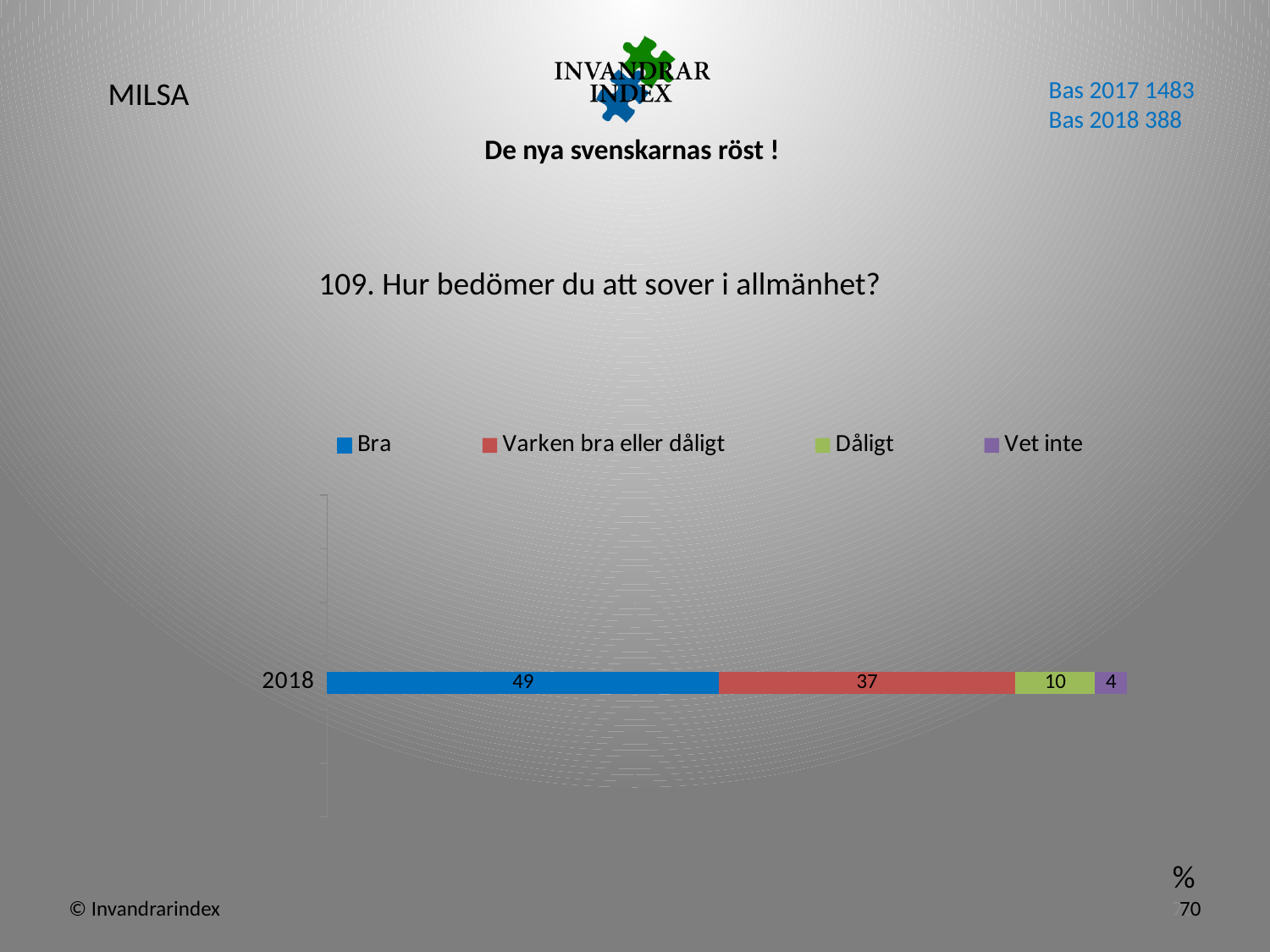
What is the value for "Bra" in the 2018 bar? 49 Which is larger in 2018, "Dåligt" or "Vet inte"? Dåligt What is the value for "Varken bra eller dåligt" in the 2018 bar? 37 What is the total of the 2018 stacked bar? 100 What is the value for "Vet inte" in the 2018 bar? 4 Which series has the lowest value in the 2018 bar? Vet inte What is the difference between the values for "Bra" and "Varken bra eller dåligt" in 2018? 12 Which series has the highest value in the 2018 bar? Bra What kind of chart is shown on the slide? Stacked bar chart What is the value for "Dåligt" in the 2018 bar? 10 How many series does the legend list? 4 What is the question number and text shown as the chart title? 109. Hur bedömer du att sover i allmänhet?